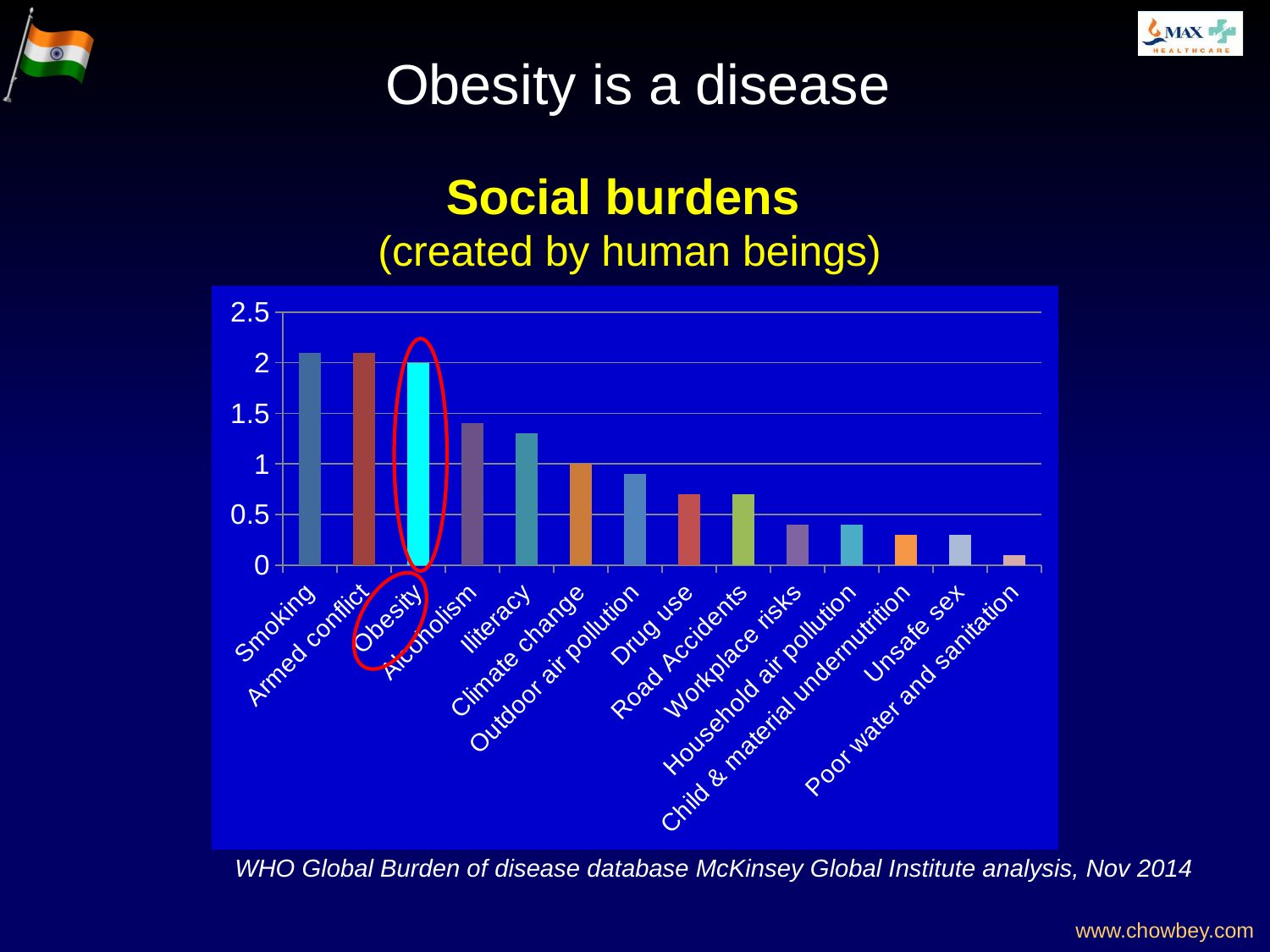
Is the value for Outdoor air pollution greater or less than 1? less Which has the larger value, Alcoholism or Drug use? Alcoholism Is the value for Illiteracy greater or less than 1? greater How many categories are shown on the x axis of the chart? 14 Is the value for Smoking greater or less than 2? greater What kind of chart is shown on the slide? bar chart Which category has the lowest value in the chart? Poor water and sanitation Which category is circled in red on the chart? Obesity Do the values generally rise or fall moving from left to right along the x axis? fall What is the title shown above the chart? Social burdens (created by human beings)